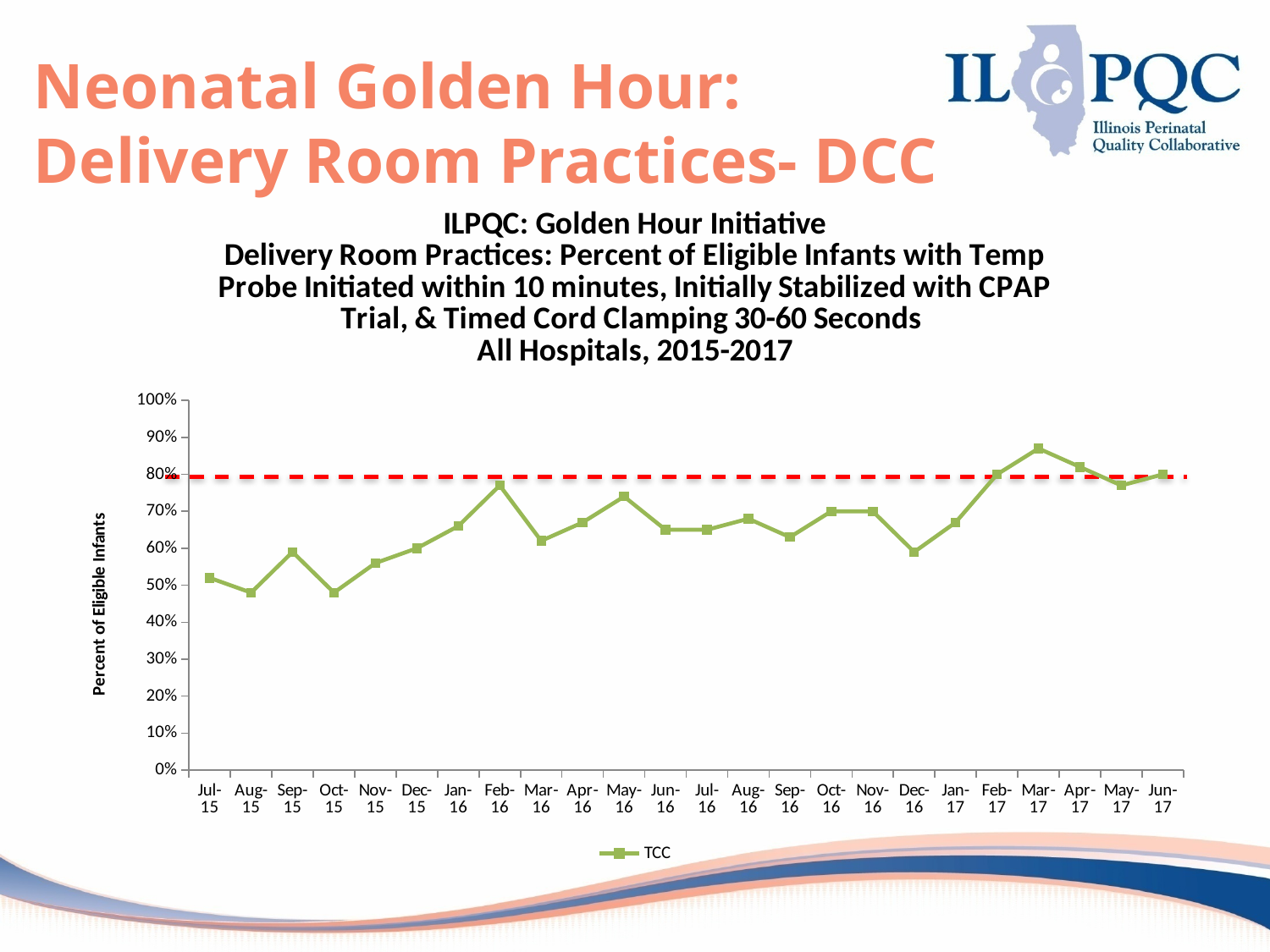
Is the value for Jul-15 greater or less than 60%? less How many monthly data points are plotted on the chart? 24 Is the value for Mar-17 greater or less than 80%? greater Is the value for Aug-15 greater or less than 50%? less Overall, do the values rise or fall from Jul-15 to Jun-17? Rise At what percentage level is the red dashed horizontal line drawn? 80% What kind of chart is shown on the slide? Line chart How many series does the legend list? 1 Which month has the highest value on the chart? Mar-17 Which is larger, the value for Feb-16 or the value for Mar-16? Feb-16 What is the name of the series shown in the legend? TCC